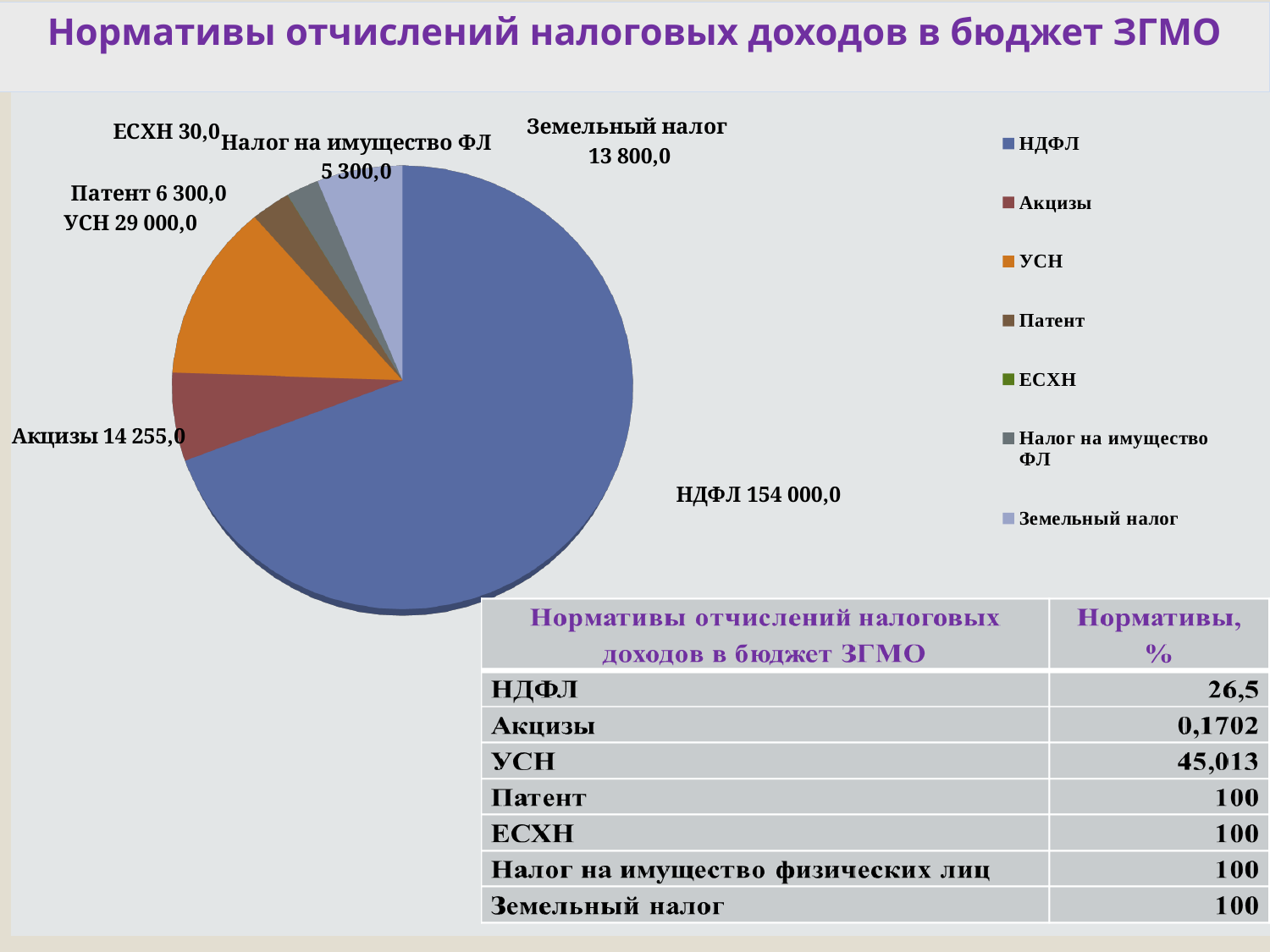
What is the value shown for Акцизы in the pie chart? 14 255,0 What type of chart is shown on the slide? Pie chart Which is larger in the pie chart, УСН or Акцизы? УСН Which category has the largest slice in the pie chart? НДФЛ Which category has the smallest value in the pie chart? ЕСХН What is the difference between the values for НДФЛ and УСН in the pie chart? 125 000,0 What is the value shown for Земельный налог in the pie chart? 13 800,0 How many slices does the pie chart have? 7 What is the value shown for УСН in the pie chart? 29 000,0 What is the value shown for НДФЛ in the pie chart? 154 000,0 How many entries does the legend of the pie chart list? 7 What is the value shown for Налог на имущество ФЛ in the pie chart? 5 300,0